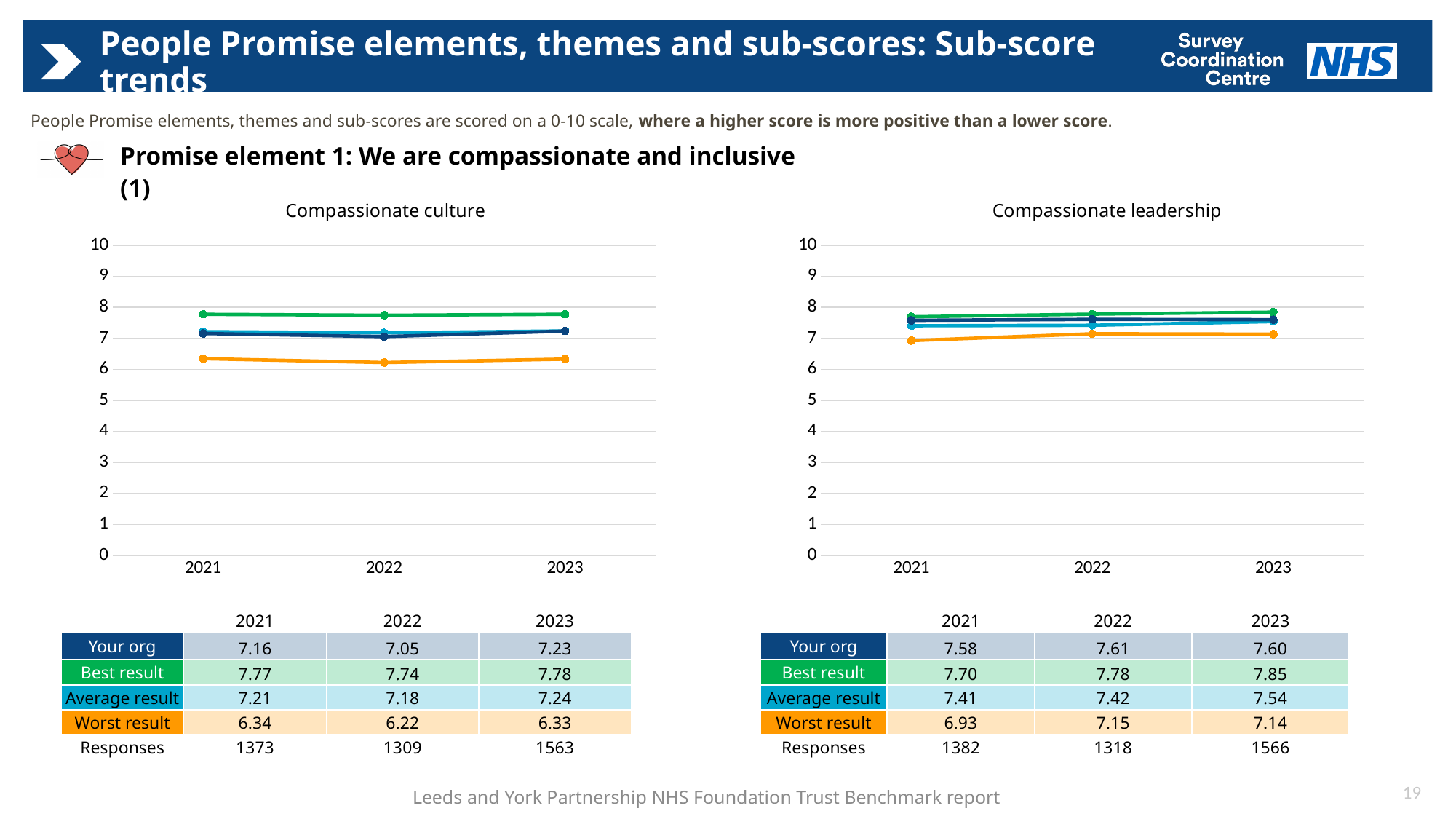
In the Compassionate leadership chart, did the Average result rise or fall from 2021 to 2023? rise In the Compassionate culture chart, is the Worst result in 2021 greater or less than 7? less In the Compassionate leadership chart, what was the Average result in 2023? 7.54 In the Compassionate culture chart, which year had the lowest Worst result score? 2022 In the Compassionate leadership chart, is the Your org score in 2022 higher or lower than the Average result in 2022? higher In the Compassionate culture chart, what was the Best result in 2022? 7.74 In the Compassionate culture chart, what is the difference between the Best result and the Worst result in 2023? 1.45 In the Compassionate culture chart, what was the Your org score in 2023? 7.23 What type of chart is the Compassionate culture chart? line chart In the Compassionate leadership chart, which year had the highest Best result score? 2023 How many years are plotted on the x axis of the Compassionate leadership chart? 3 In the Compassionate leadership chart, what was the Worst result in 2021? 6.93